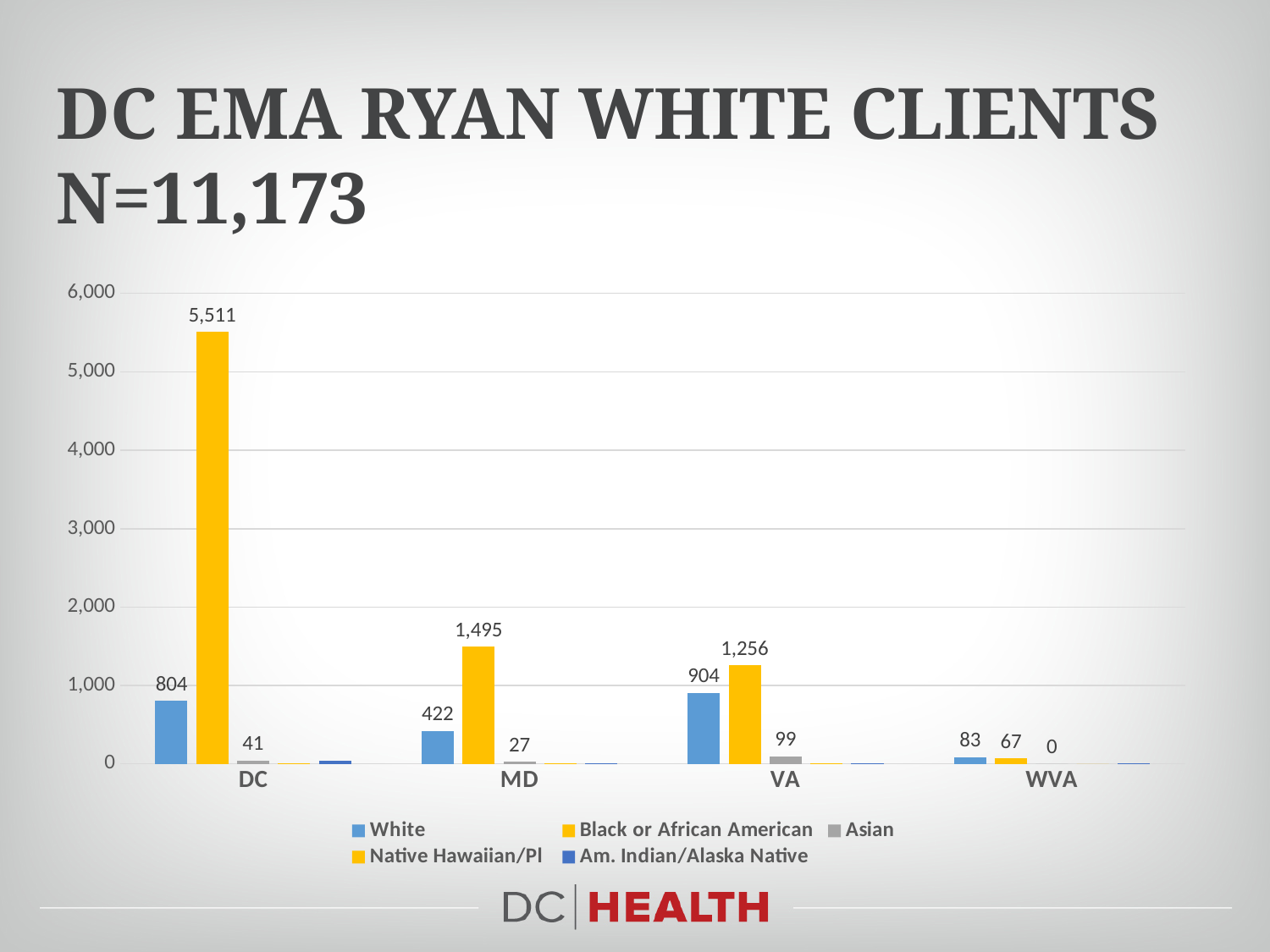
Which jurisdiction has the lowest number of White clients? WVA What is the value for Asian clients in WVA? 0 Is the value for White clients in DC greater or less than 1,000? less What is the value for Black or African American clients in DC? 5,511 How many series does the legend list? 5 Which is larger: White clients in WVA or Black or African American clients in WVA? White clients in WVA How many jurisdictions are shown on the x axis? 4 What is the value for Asian clients in MD? 27 What is the value for White clients in VA? 904 Which jurisdiction has the highest number of Black or African American clients? DC What kind of chart is shown on the slide? Bar chart What is the difference between Black or African American clients in MD and in VA? 239